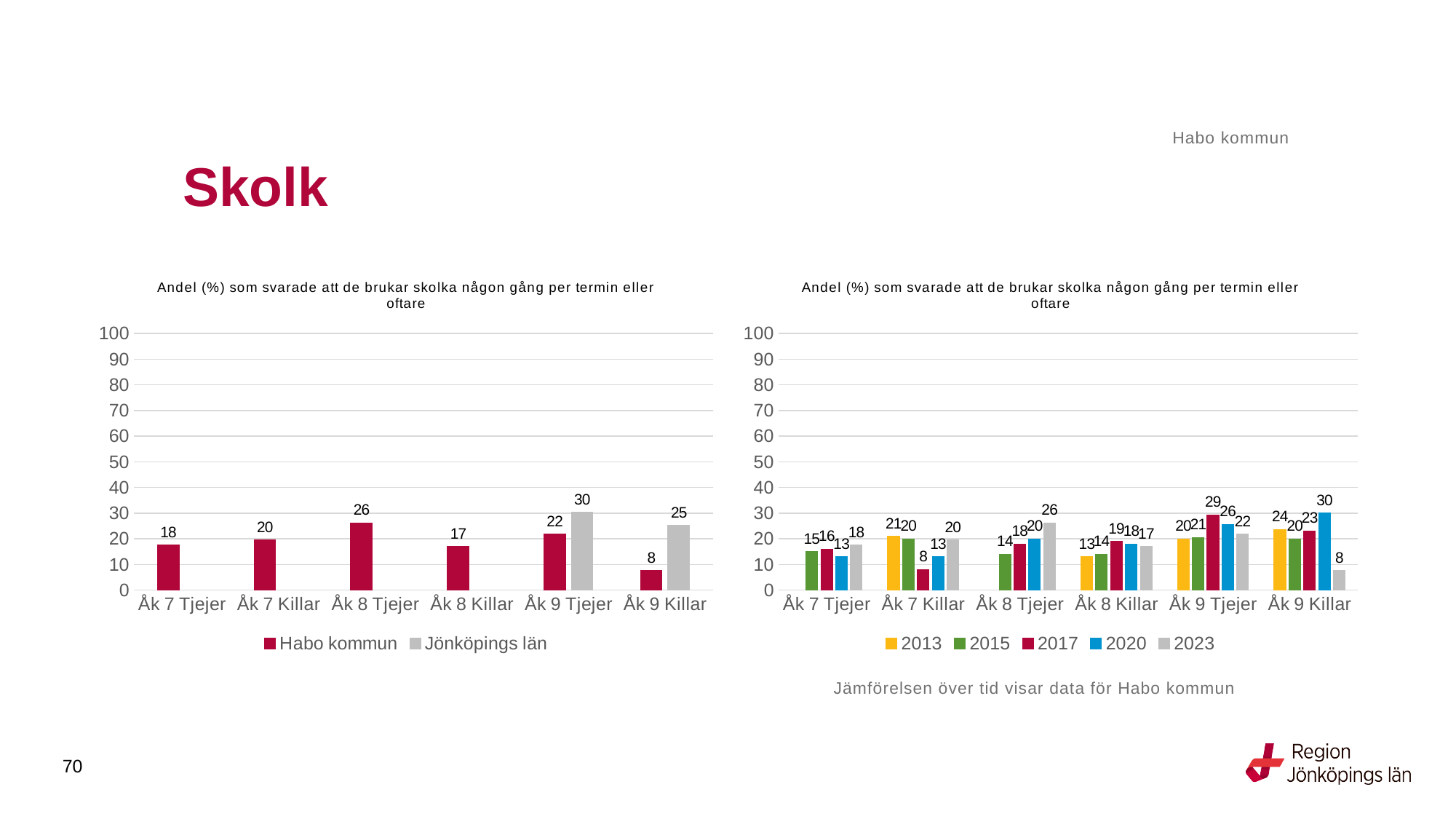
In the right chart, what is the value for 2017 for Åk 7 Killar? 8 In the left chart, how many series does the legend list? 2 In the left chart, what is the value for Jönköpings län for Åk 9 Tjejer? 30 In the right chart, what is the difference between the 2023 and 2015 values for Åk 8 Tjejer? 12 In the right chart, what is the value for 2020 for Åk 9 Killar? 30 In the left chart, which category has the lowest value for Habo kommun? Åk 9 Killar In the right chart, which year has the highest value for Åk 9 Tjejer? 2017 What kind of chart is the left chart? Bar chart In the right chart, how many series does the legend list? 5 In the left chart, what is the value for Habo kommun for Åk 8 Tjejer? 26 In the right chart, is the value for 2023 larger for Åk 8 Tjejer or for Åk 8 Killar? Åk 8 Tjejer In the left chart, what is the difference between Jönköpings län and Habo kommun for Åk 9 Killar? 17